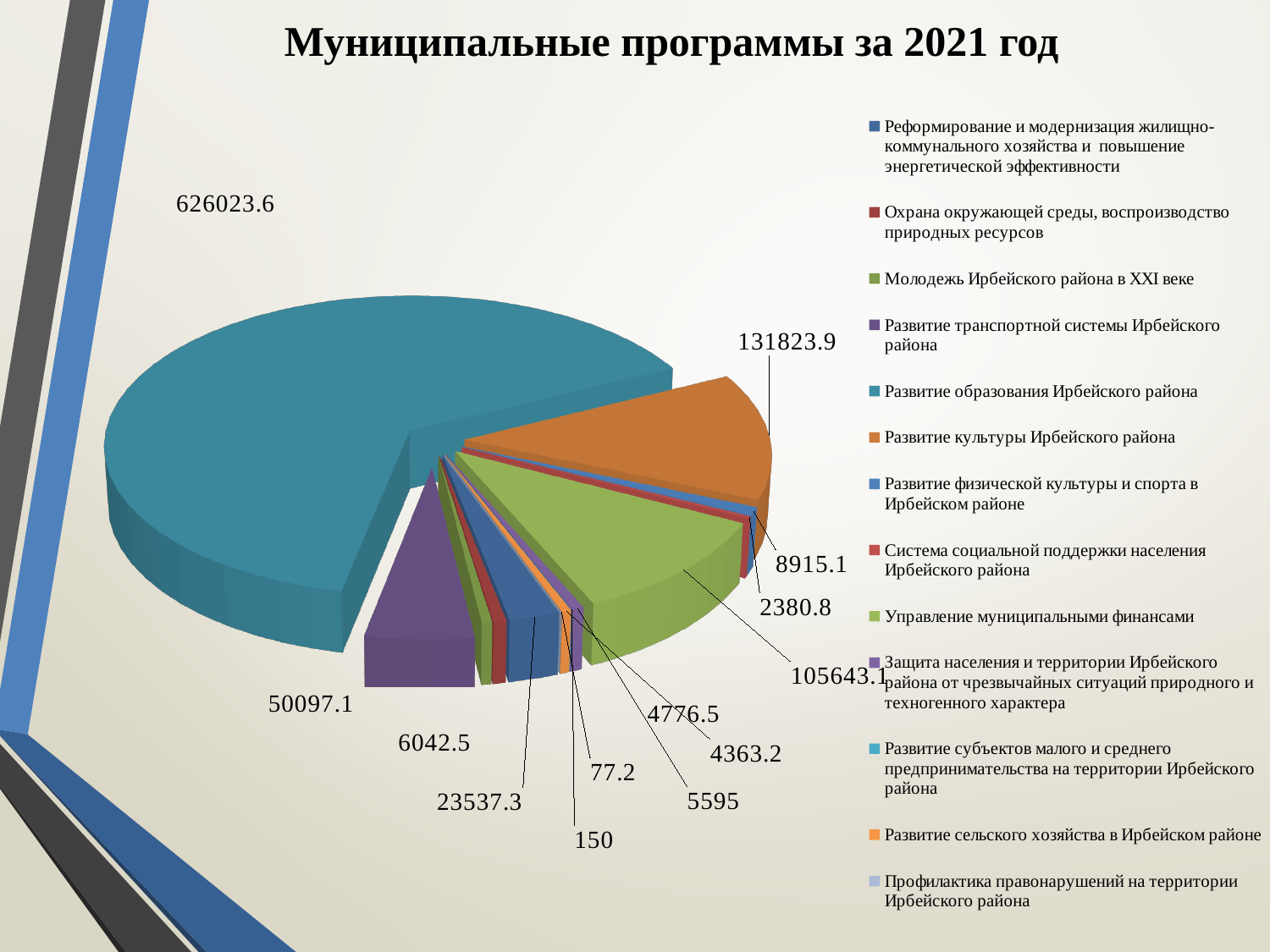
What type of chart is shown on the slide? Pie chart What is the difference between the values for Развитие образования Ирбейского района and Развитие культуры Ирбейского района? 494199.7 How many categories does the legend list? 13 Which is larger: Развитие образования Ирбейского района or Развитие культуры Ирбейского района? Развитие образования Ирбейского района What is the value for Развитие транспортной системы Ирбейского района? 50097.1 What is the value for Развитие культуры Ирбейского района? 131823.9 Which category has the largest slice of the pie? Развитие образования Ирбейского района What is the value for Управление муниципальными финансами? 105643.1 What is the value for Развитие образования Ирбейского района? 626023.6 What is the difference between the values for Развитие культуры Ирбейского района and Управление муниципальными финансами? 26180.8 What is the smallest value labelled on the chart? 77.2 What is the title of the chart? Муниципальные программы за 2021 год